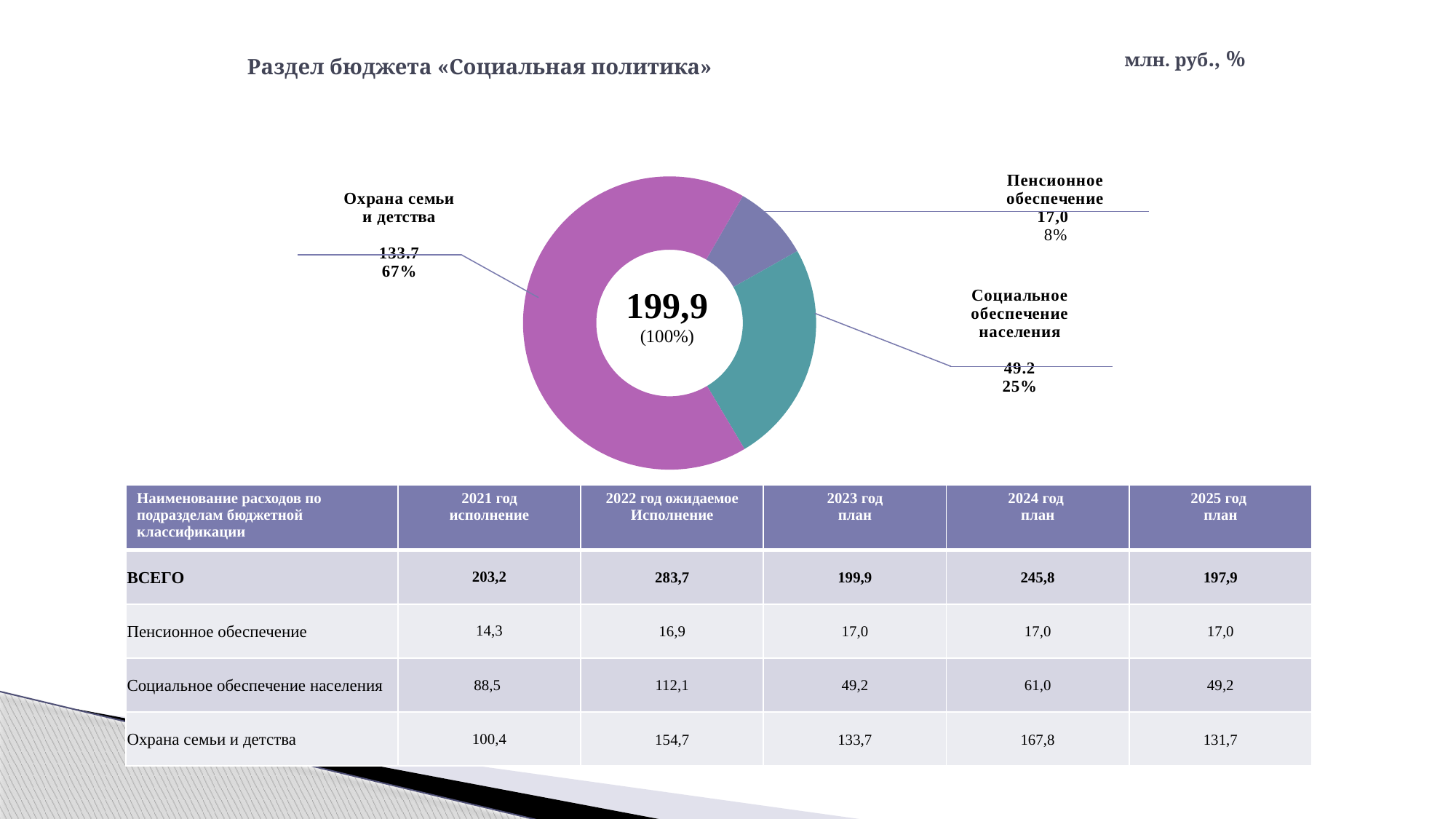
What kind of chart is shown on the slide? Pie chart (donut) How many slices does the donut chart have? 3 Which is larger on the donut chart, Социальное обеспечение населения or Пенсионное обеспечение? Социальное обеспечение населения What total value is shown in the centre of the donut chart? 199,9 Which slice of the donut chart is the largest? Охрана семьи и детства What is the value shown for Охрана семьи и детства on the donut chart? 133.7 What is the value shown for Социальное обеспечение населения on the donut chart? 49.2 What is the value shown for Пенсионное обеспечение on the donut chart? 17,0 What share of the donut chart does Социальное обеспечение населения represent? 25% What share of the donut chart does Охрана семьи и детства represent? 67% What share of the donut chart does Пенсионное обеспечение represent? 8% Which slice of the donut chart is the smallest? Пенсионное обеспечение